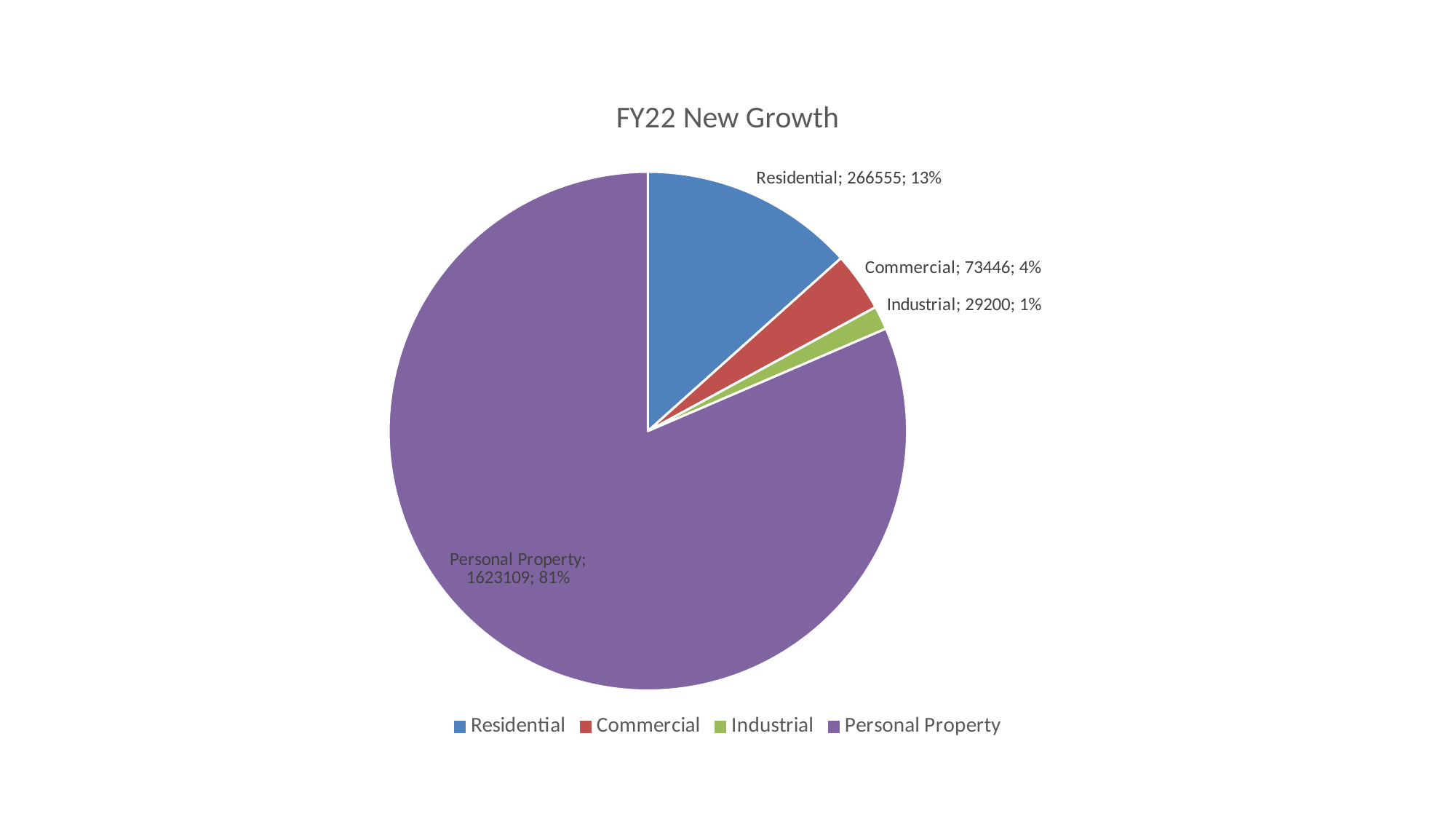
What is the value for Personal Property? 1623109 What is the value for Commercial? 73446 What share of the pie does Residential represent? 13% What is the difference between the Residential and Commercial values? 193109 How many categories are shown in the pie chart? 4 Which category has the largest slice? Personal Property Which category has the smallest slice? Industrial What is the value for Industrial? 29200 What is the value for Residential? 266555 Which is larger, Commercial or Industrial? Commercial What share of the pie does Commercial represent? 4% What is the title of the chart? FY22 New Growth